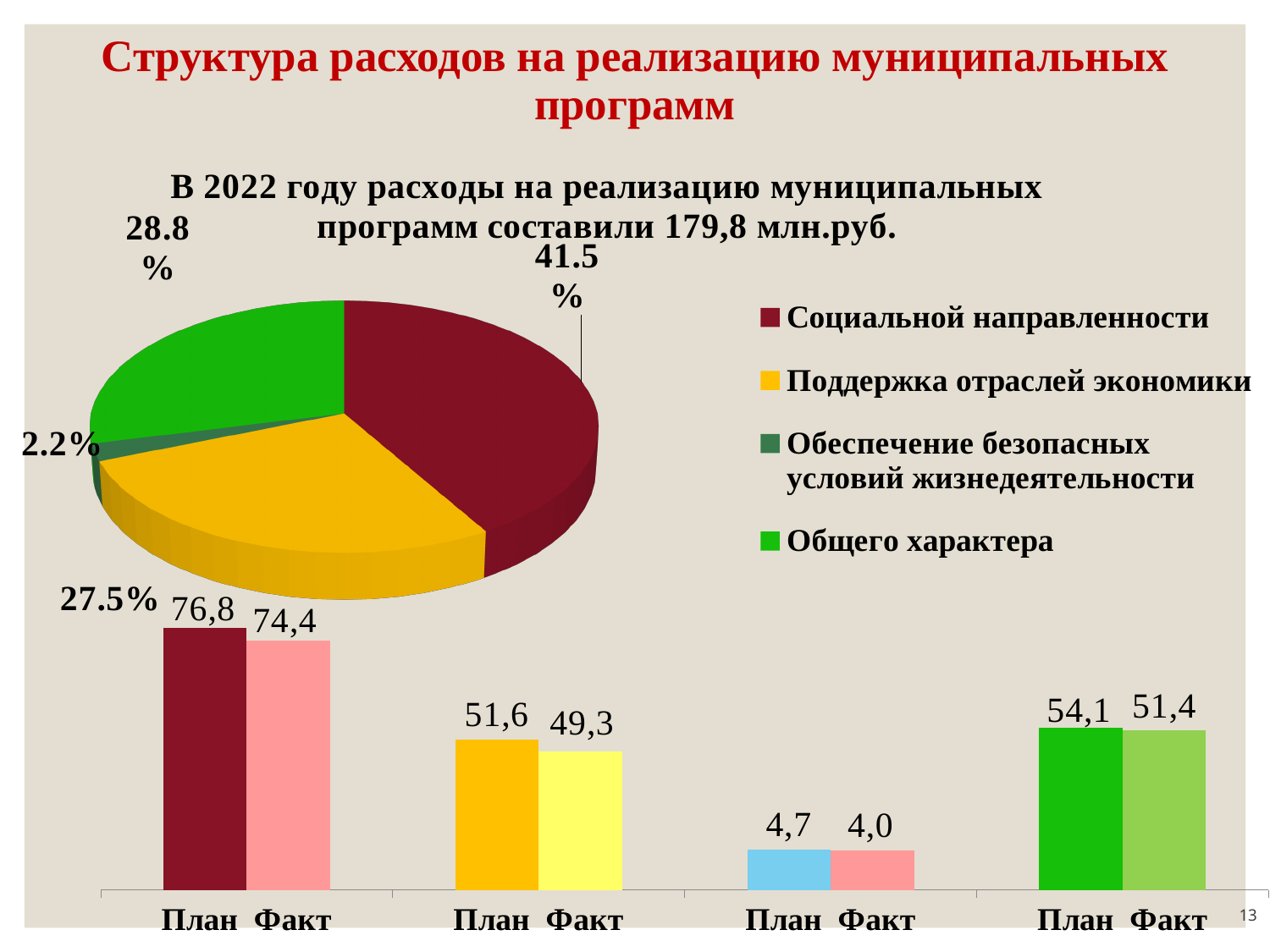
In the pie chart, which category has the largest slice? Социальной направленности In the pie chart, what share is shown for Общего характера? 28.8% In the pie chart, which category has the smallest slice? Обеспечение безопасных условий жизнедеятельности In the pie chart, what share is shown for Социальной направленности? 41.5% In the pie chart, by how many percentage points does the Социальной направленности slice exceed the Общего характера slice? 12.7 In the lower bar chart, what is the Факт value in the third group of bars? 4,0 What kind of chart is the upper chart on the slide? Pie chart How many entries does the legend of the pie chart list? 4 In the lower bar chart, what is the План value in the first (leftmost) group of bars? 76,8 What kind of chart is the lower chart on the slide? Bar chart In the lower bar chart, what is the difference between План and Факт in the fourth (rightmost) group of bars? 2,7 In the lower bar chart, which is larger in the second group of bars, План or Факт? План